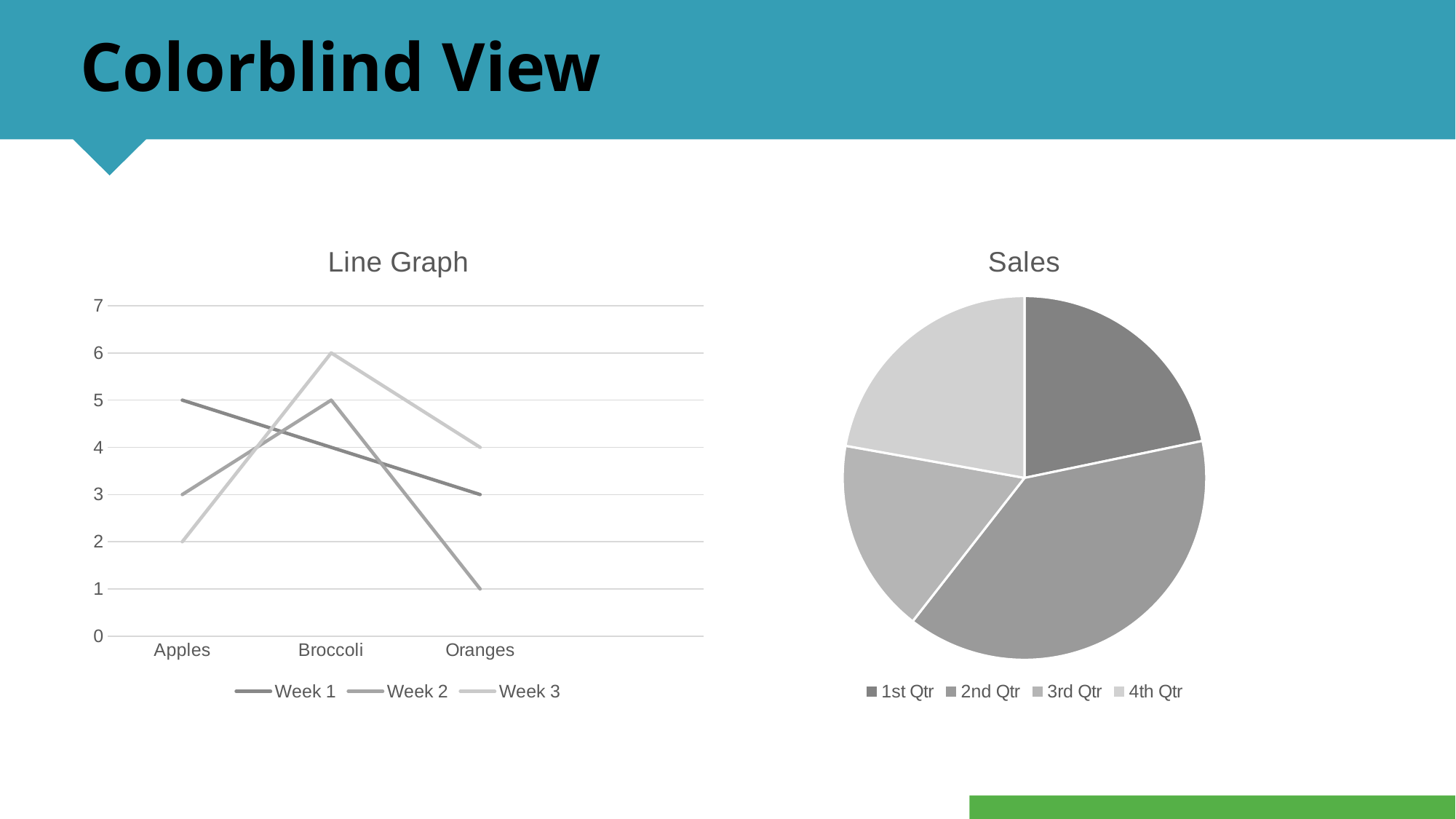
In the "Line Graph" chart, which category has the highest value for Week 2? Broccoli How many series does the legend of the "Line Graph" chart list? 3 In the "Line Graph" chart, what is the difference between the Week 3 value at Broccoli and the Week 3 value at Apples? 4 In the "Sales" pie chart, which quarter has the largest slice? 2nd Qtr In the "Line Graph" chart, what is the value for Week 2 at Oranges? 1 What type of chart is the "Line Graph" chart on the left? line chart How many slices does the "Sales" pie chart have? 4 In the "Line Graph" chart, which category has the lowest value for Week 3? Apples In the "Line Graph" chart, what is the value for Week 1 at Apples? 5 What type of chart is the "Sales" chart on the right? pie chart In the "Line Graph" chart, does the Week 1 line rise or fall from Apples to Oranges? fall In the "Line Graph" chart, what is the value for Week 3 at Broccoli? 6